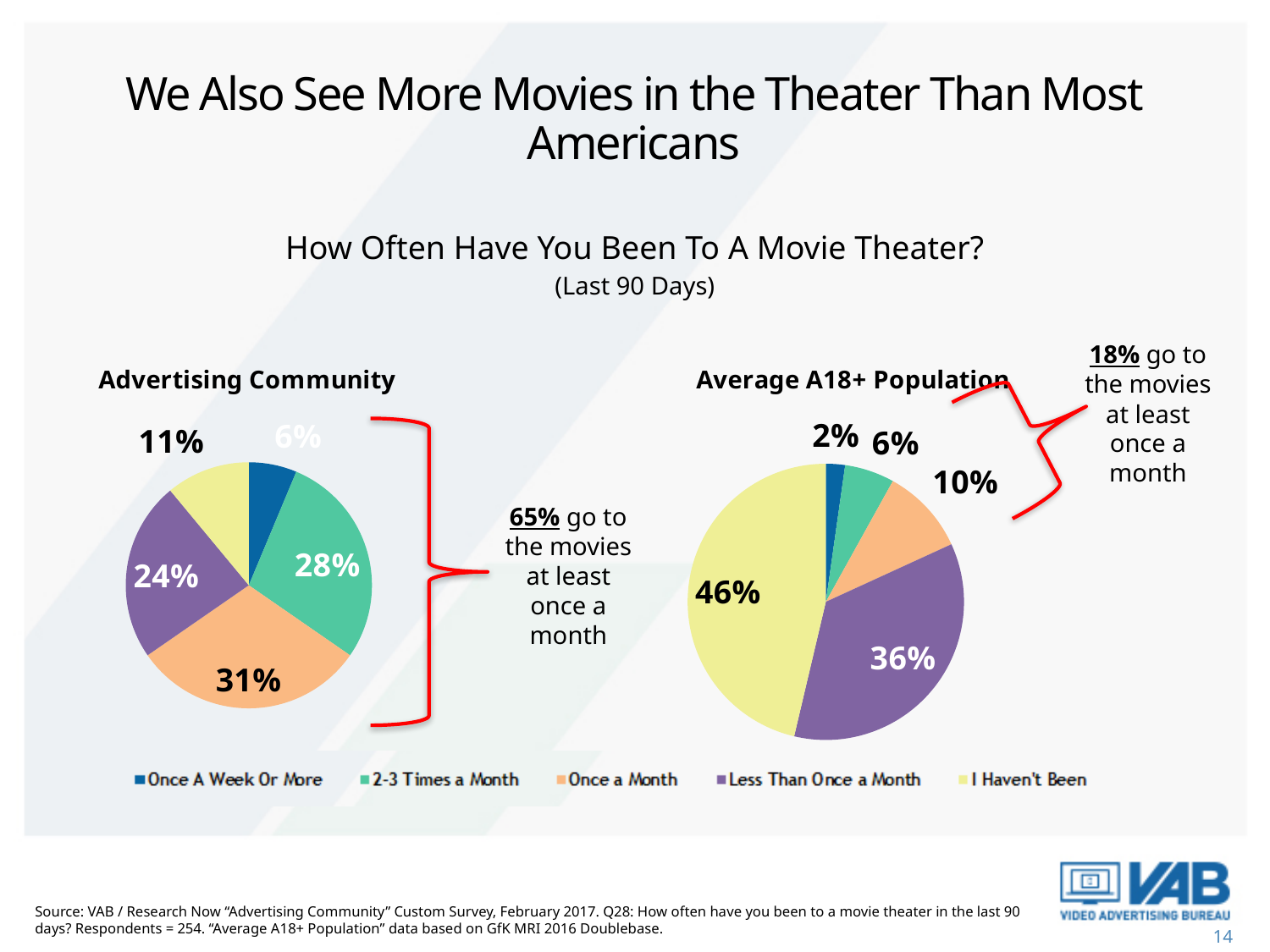
What is the difference between the I Haven't Been share in the Average A18+ Population chart and the I Haven't Been share in the Advertising Community chart? 35 percentage points In the Average A18+ Population chart, what share of respondents go Once A Week Or More? 2% In the Advertising Community chart, what share of respondents go to the movies Once a Month? 31% In the Average A18+ Population chart, what share of respondents answered I Haven't Been? 46% How many categories does the legend list for the pie charts? 5 In the Advertising Community chart, which category has the largest share? Once a Month In the Advertising Community chart, what share of respondents go 2-3 Times a Month? 28% In the Average A18+ Population chart, which category has the smallest share? Once A Week Or More What kind of chart is used for the Advertising Community data? Pie chart Which is larger: the Less Than Once a Month share in the Advertising Community chart or in the Average A18+ Population chart? Average A18+ Population What is the combined share of Once A Week Or More, 2-3 Times a Month and Once a Month in the Advertising Community chart? 65% Which colour represents the I Haven't Been category in the pie charts? Yellow